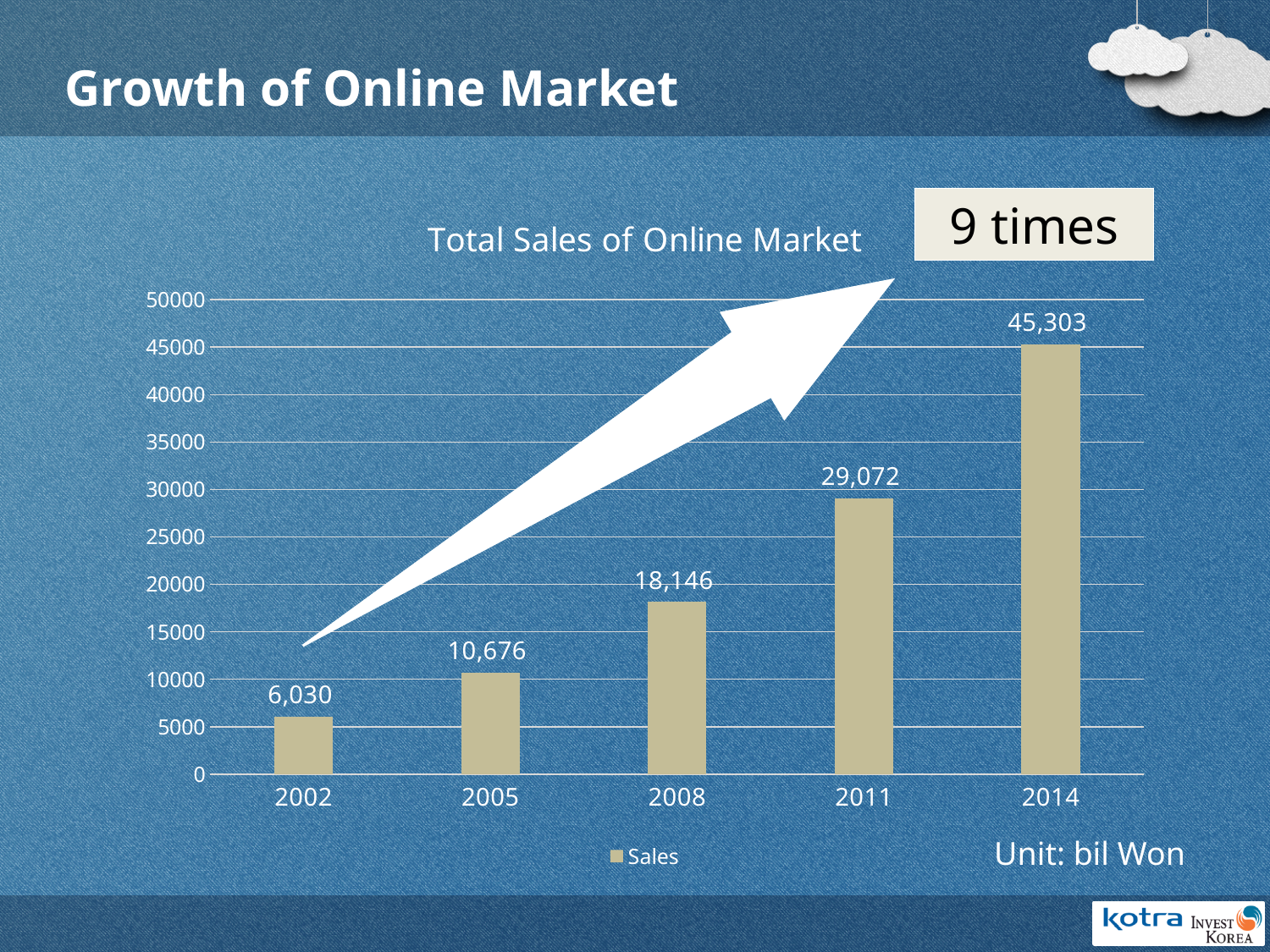
What is the value for 2002? 6,030 What is the value for 2008? 18,146 Which year has the highest total sales? 2014 Which is larger, the value for 2008 or the value for 2011? 2011 What kind of chart is this? bar chart What is the value for 2014? 45,303 How many years are shown on the x axis? 5 Is the value for 2011 greater or less than 25000? greater What is the difference between the values for 2005 and 2002? 4,646 Do the values rise or fall from 2002 to 2014? rise What is the difference between the values for 2014 and 2011? 16,231 Which year has the lowest total sales? 2002